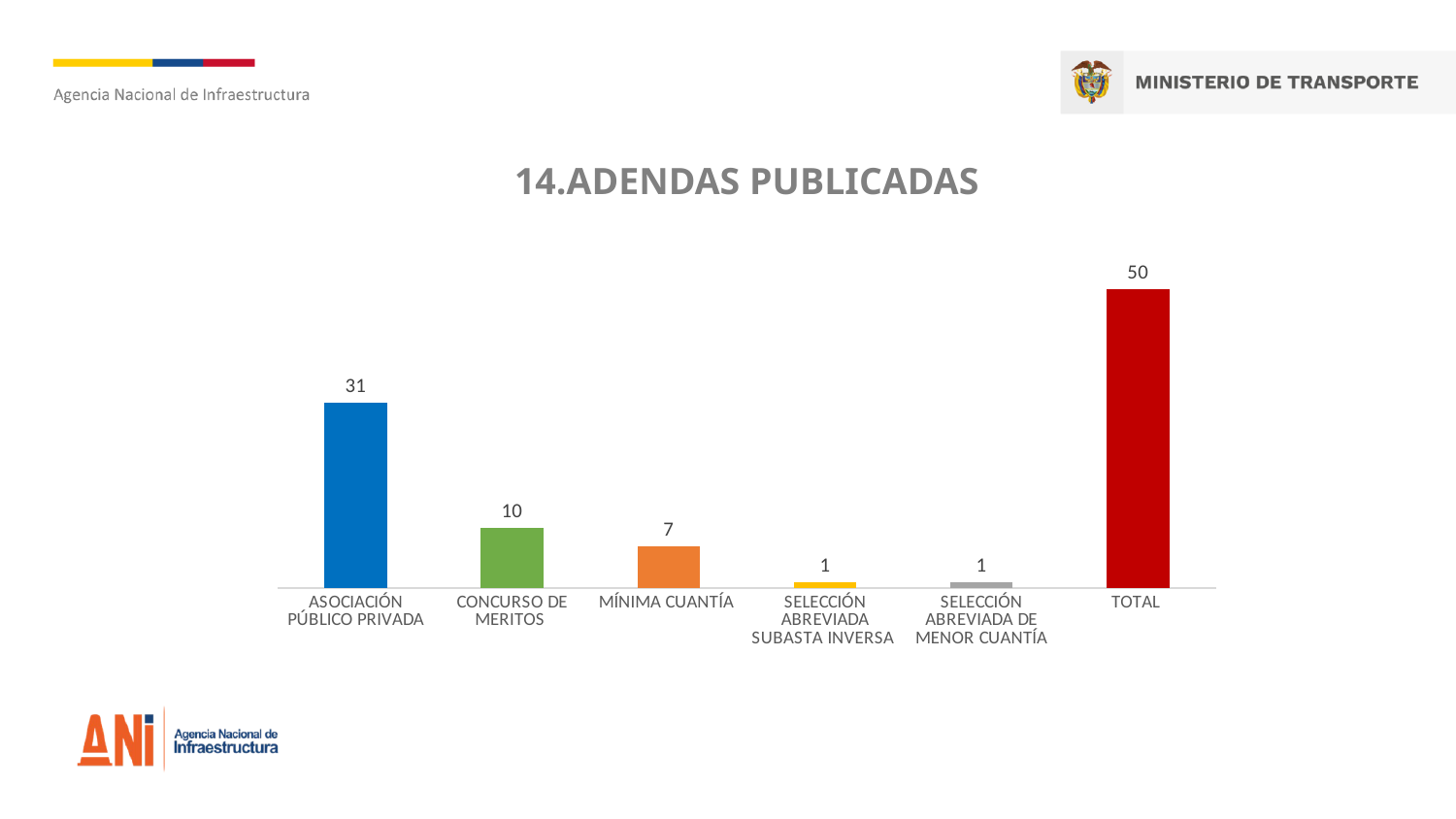
What is the value for ASOCIACIÓN PÚBLICO PRIVADA? 31 What is the value for CONCURSO DE MERITOS? 10 What is the title of the chart? 14.ADENDAS PUBLICADAS Excluding the TOTAL bar, which category has the highest value? ASOCIACIÓN PÚBLICO PRIVADA What is the value for MÍNIMA CUANTÍA? 7 What kind of chart is shown on the slide? Bar chart What is the difference between the values for ASOCIACIÓN PÚBLICO PRIVADA and CONCURSO DE MERITOS? 21 What is the value for SELECCIÓN ABREVIADA SUBASTA INVERSA? 1 What colour is the TOTAL bar? Red Which is larger, the value for CONCURSO DE MERITOS or the value for MÍNIMA CUANTÍA? CONCURSO DE MERITOS How many bars are shown in the chart? 6 What is the value shown for the TOTAL bar? 50